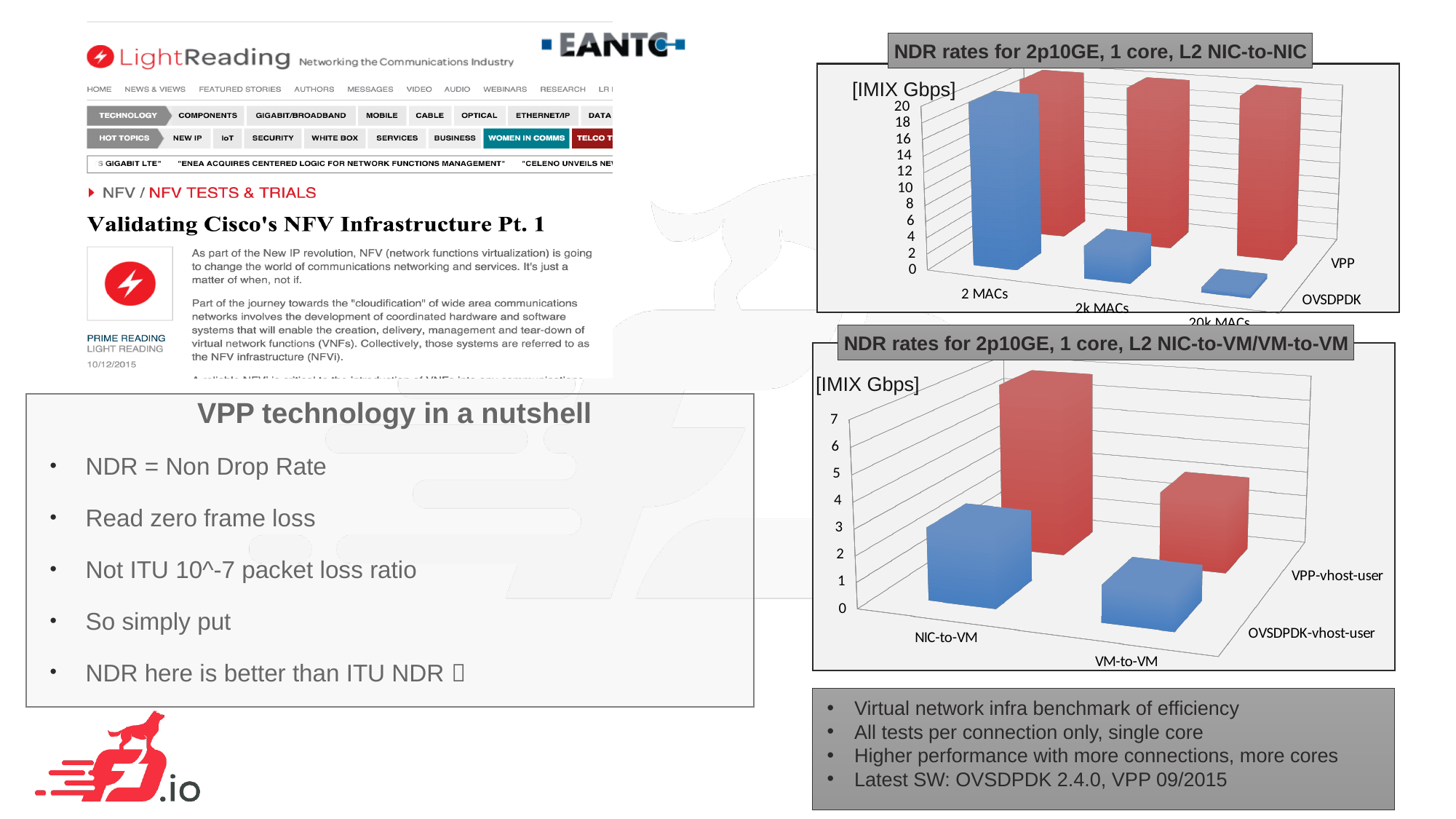
In the 'NDR rates for 2p10GE, 1 core, L2 NIC-to-VM/VM-to-VM' chart, which series has the larger value for NIC-to-VM, VPP-vhost-user or OVSDPDK-vhost-user? VPP-vhost-user What unit is shown on the y axis of the 'NDR rates for 2p10GE, 1 core, L2 NIC-to-NIC' chart? [IMIX Gbps] In the 'NDR rates for 2p10GE, 1 core, L2 NIC-to-NIC' chart, for which category is the OVSDPDK value lowest? 20k MACs In the 'NDR rates for 2p10GE, 1 core, L2 NIC-to-NIC' chart, which series has the larger value at 20k MACs, VPP or OVSDPDK? VPP In the 'NDR rates for 2p10GE, 1 core, L2 NIC-to-VM/VM-to-VM' chart, for which category is the VPP-vhost-user value highest? NIC-to-VM In the 'NDR rates for 2p10GE, 1 core, L2 NIC-to-NIC' chart, do the OVSDPDK values rise or fall from 2 MACs to 20k MACs? fall How many series does the 'NDR rates for 2p10GE, 1 core, L2 NIC-to-VM/VM-to-VM' chart show? 2 How many series does the 'NDR rates for 2p10GE, 1 core, L2 NIC-to-NIC' chart show? 2 How many categories are shown on the x axis of the 'NDR rates for 2p10GE, 1 core, L2 NIC-to-NIC' chart? 3 In the 'NDR rates for 2p10GE, 1 core, L2 NIC-to-VM/VM-to-VM' chart, is the VPP-vhost-user value for NIC-to-VM greater or less than 5? greater What kind of chart is the 'NDR rates for 2p10GE, 1 core, L2 NIC-to-NIC' chart? bar chart In the 'NDR rates for 2p10GE, 1 core, L2 NIC-to-NIC' chart, is the OVSDPDK value for 20k MACs greater or less than 4? less